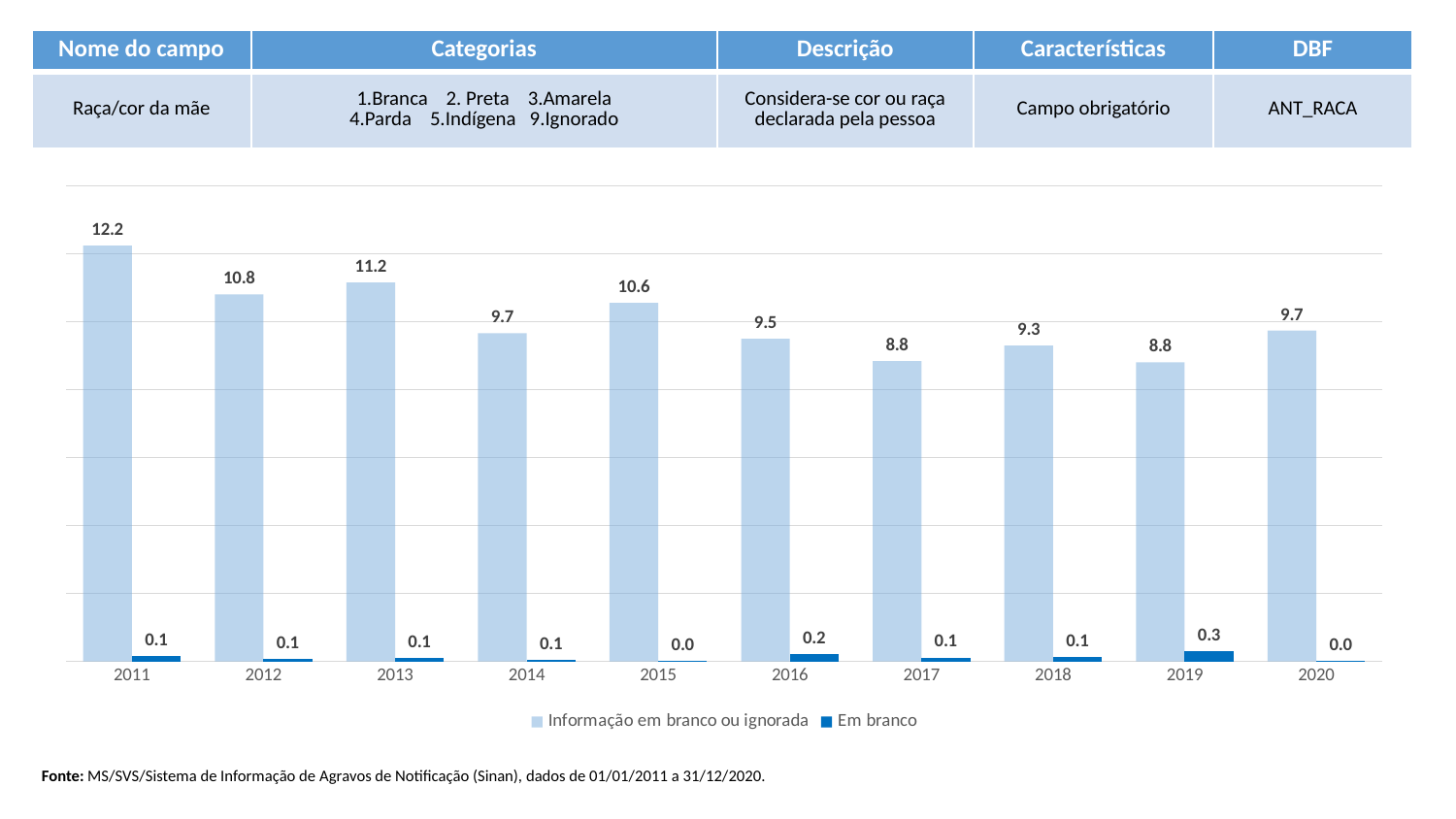
Which year has the highest value for "Informação em branco ou ignorada"? 2011 What is the value of "Informação em branco ou ignorada" for 2011? 12.2 What is the value of "Em branco" for 2019? 0.3 Which is larger, the "Informação em branco ou ignorada" value for 2013 or for 2015? 2013 How many series does the chart legend list? 2 What kind of chart is shown on the slide? Bar chart How many years are shown on the x axis of the chart? 10 What is the name of the second series in the chart legend? Em branco What is the difference between the "Informação em branco ou ignorada" values for 2011 and 2012? 1.4 Does the "Informação em branco ou ignorada" value rise or fall from 2011 to 2012? Fall Which year has the highest value for "Em branco"? 2019 What is the value of "Informação em branco ou ignorada" for 2020? 9.7